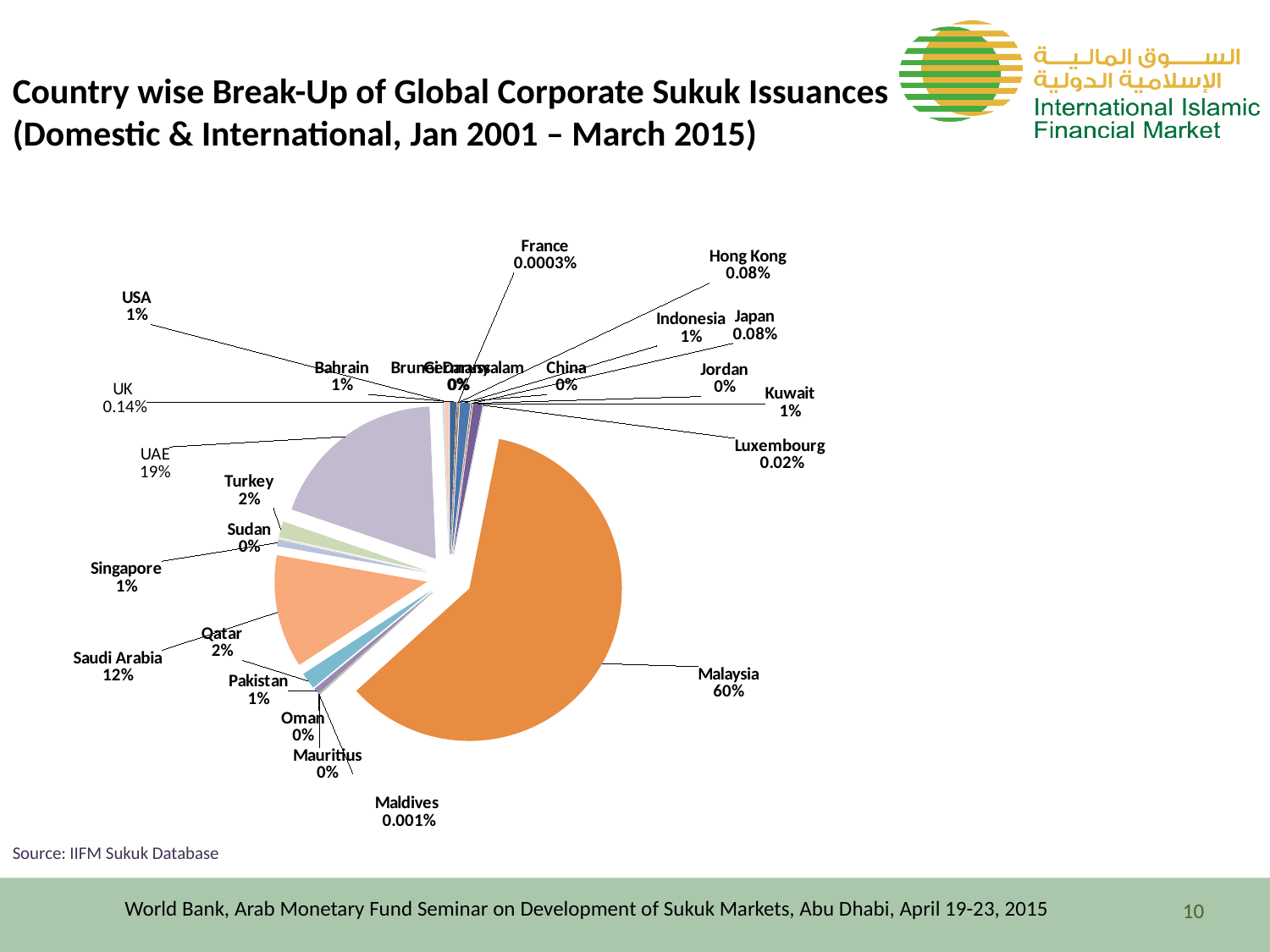
What is the source cited for the chart data? IIFM Sukuk Database What share is shown for Maldives? 0.001% Which has a larger share, UAE or Saudi Arabia? UAE Which country has the largest share of global corporate sukuk issuances? Malaysia What share is shown for the UK? 0.14% What is the share shown for UAE? 19% What is the difference in percentage points between Malaysia's share and UAE's share? 41% What share is shown for France? 0.0003% What share is shown for Luxembourg? 0.02% What is the share shown for Saudi Arabia? 12% What share of global corporate sukuk issuances does Malaysia account for? 60% What kind of chart is shown on the slide? pie chart